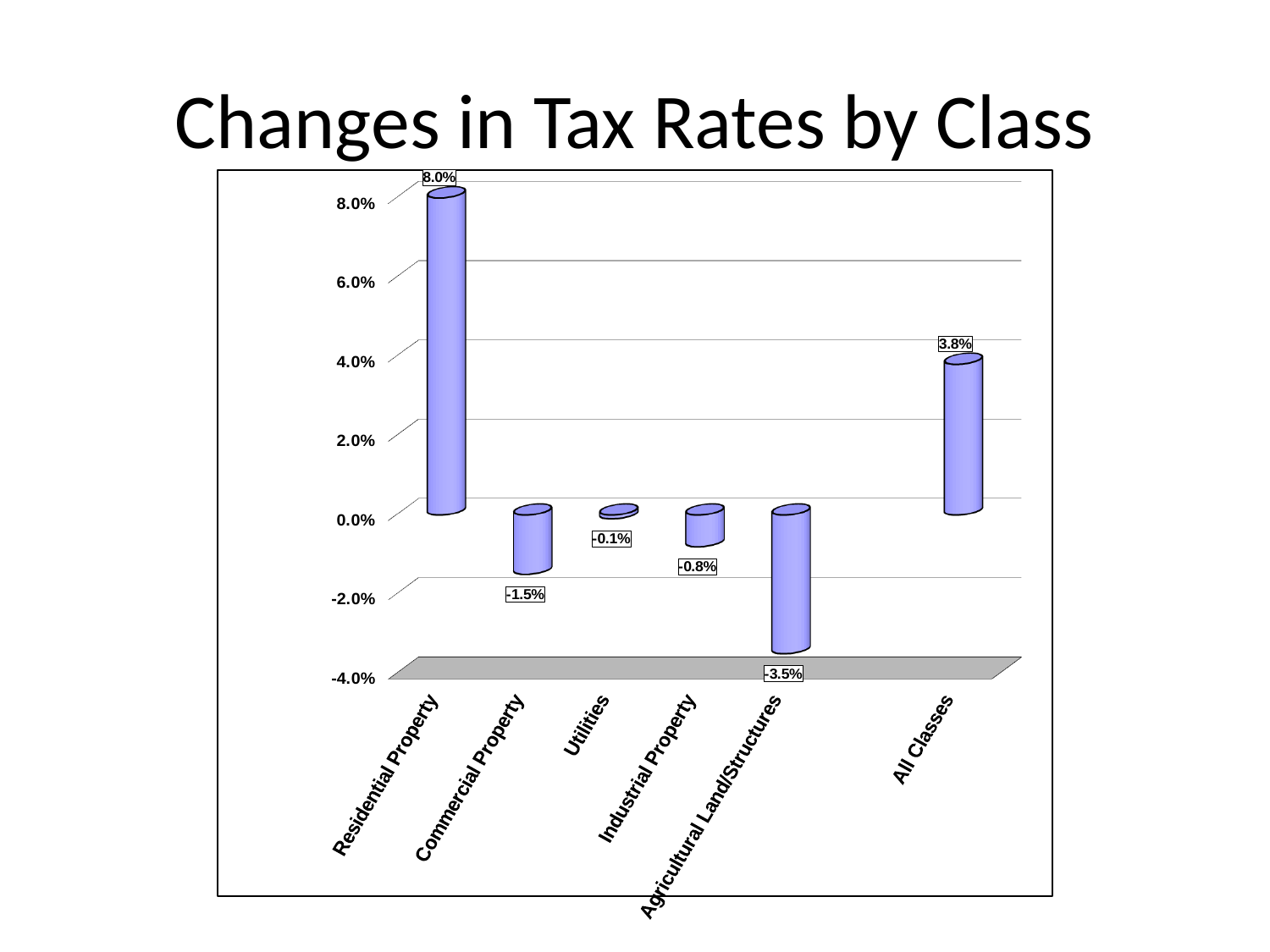
How many categories are shown on the x axis? 6 What is the value for Commercial Property? -1.5% Which is larger, the value for Commercial Property or the value for Industrial Property? Industrial Property What is the value for Residential Property? 8.0% What is the difference between the values for Residential Property and All Classes? 4.2% Which category has the highest value? Residential Property What kind of chart is shown on the slide? Bar chart What is the value for All Classes? 3.8% What is the value for Utilities? -0.1% What is the title of the slide? Changes in Tax Rates by Class Which category has the lowest value? Agricultural Land/Structures What is the value for Agricultural Land/Structures? -3.5%